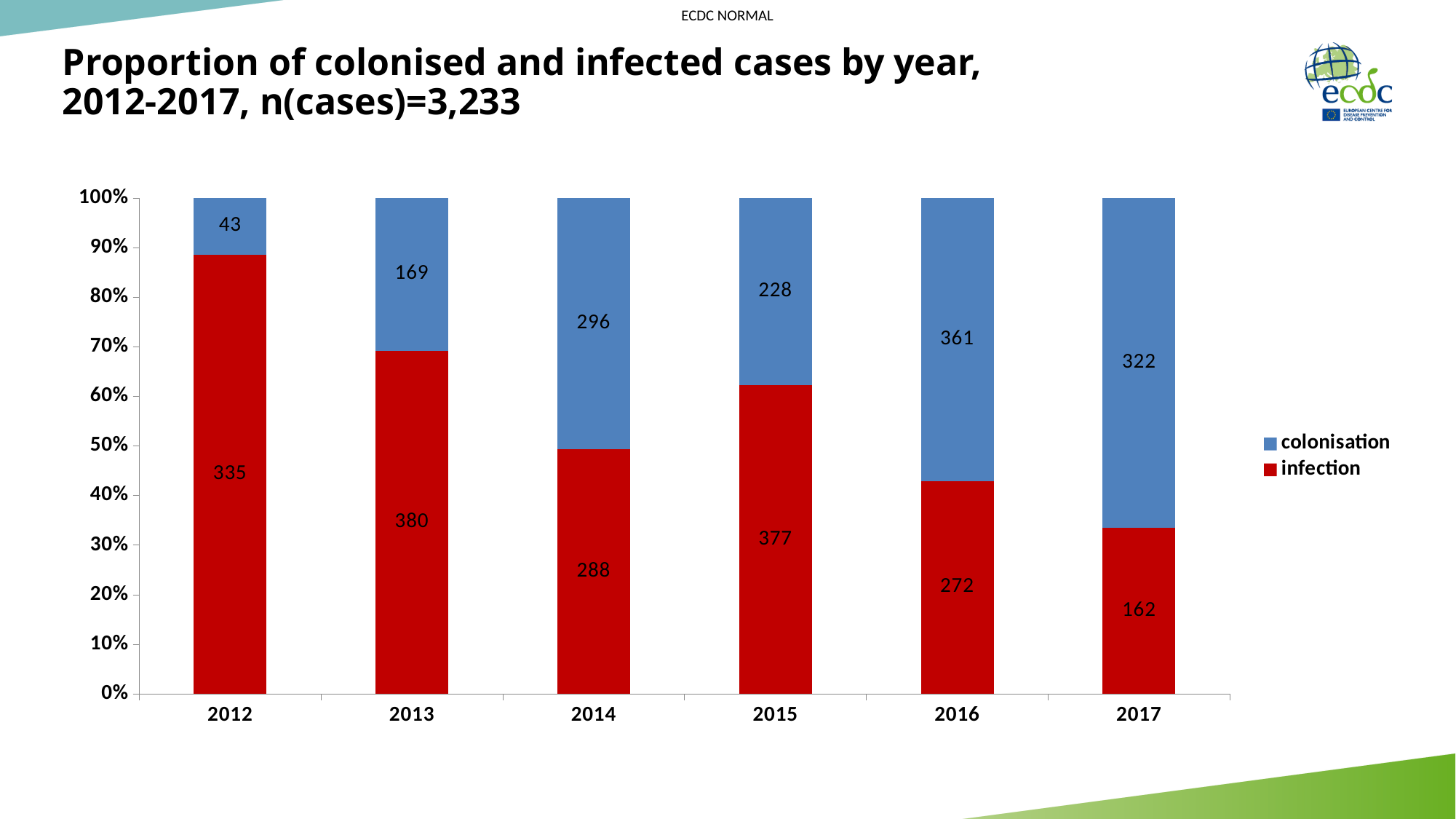
What is the total number of cases in 2012 (infection plus colonisation)? 378 What is the colonisation count for 2012? 43 Is the infection share of the 2015 bar greater or less than 50%? greater Which year has the lowest infection count? 2017 What is the infection count for 2013? 380 What kind of chart is shown? stacked bar chart What is the colonisation count for 2016? 361 What is the difference between the infection count and the colonisation count in 2017? 160 Which year has the highest colonisation count? 2016 How many years are shown on the x axis? 6 How many series does the legend list? 2 Which is larger in 2014, the infection count or the colonisation count? colonisation